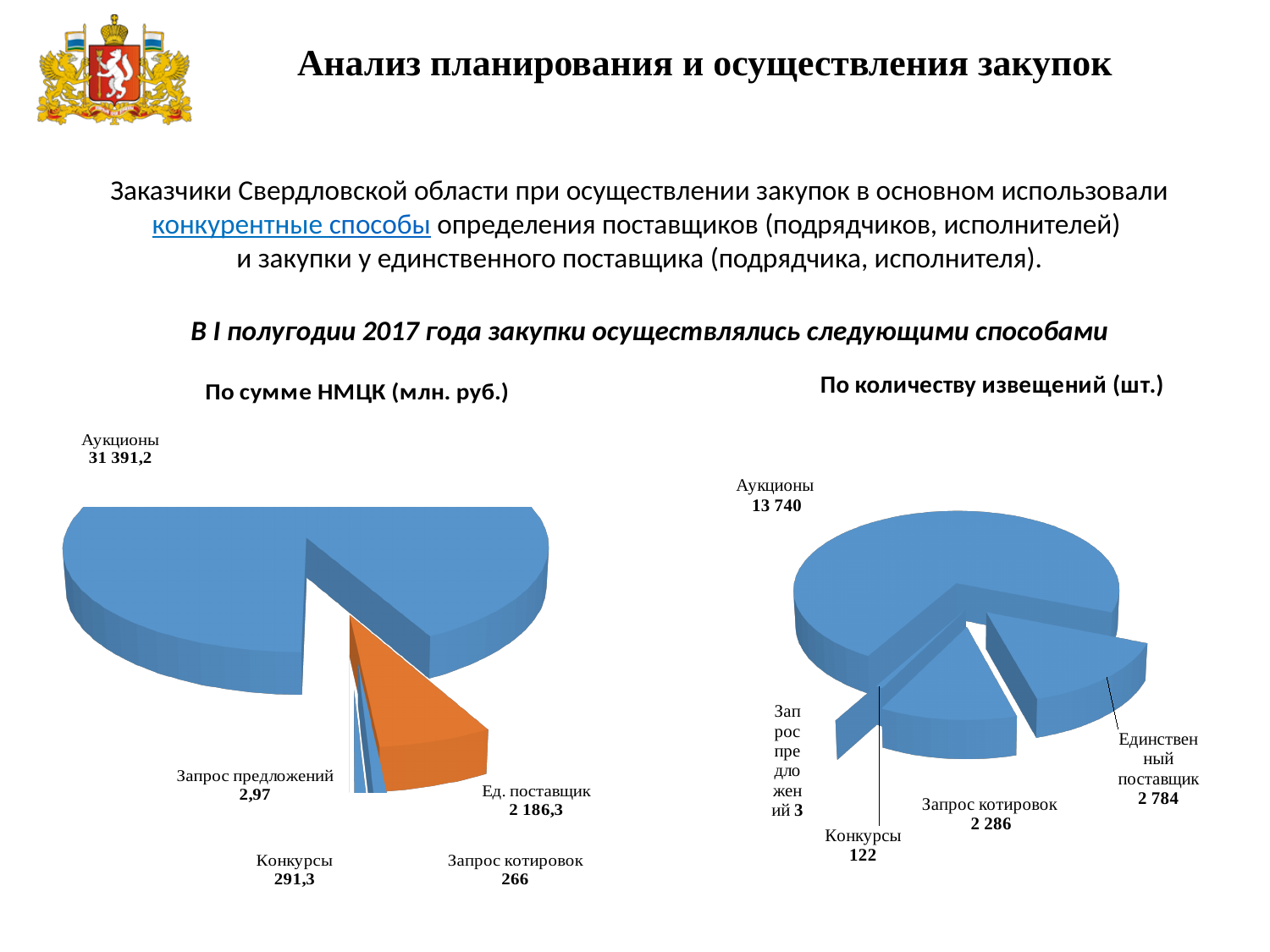
In the chart 'По сумме НМЦК (млн. руб.)', which category has the smallest value? Запрос предложений In the chart 'По количеству извещений (шт.)', what is the difference between Единственный поставщик and Запрос котировок? 498 In the chart 'По сумме НМЦК (млн. руб.)', what is the difference between Конкурсы and Запрос котировок? 25,3 In the chart 'По количеству извещений (шт.)', which is larger: Единственный поставщик or Запрос котировок? Единственный поставщик In the chart 'По количеству извещений (шт.)', what is the value for Конкурсы? 122 In the chart 'По количеству извещений (шт.)', what is the value for Запрос котировок? 2 286 What type of chart is 'По количеству извещений (шт.)'? Pie chart How many categories are shown in the chart 'По сумме НМЦК (млн. руб.)'? 5 In the chart 'По сумме НМЦК (млн. руб.)', which category has the largest value? Аукционы In the chart 'По количеству извещений (шт.)', which category has the smallest value? Запрос предложений In the chart 'По сумме НМЦК (млн. руб.)', what is the value for Аукционы? 31 391,2 In the chart 'По сумме НМЦК (млн. руб.)', what is the value for Ед. поставщик? 2 186,3